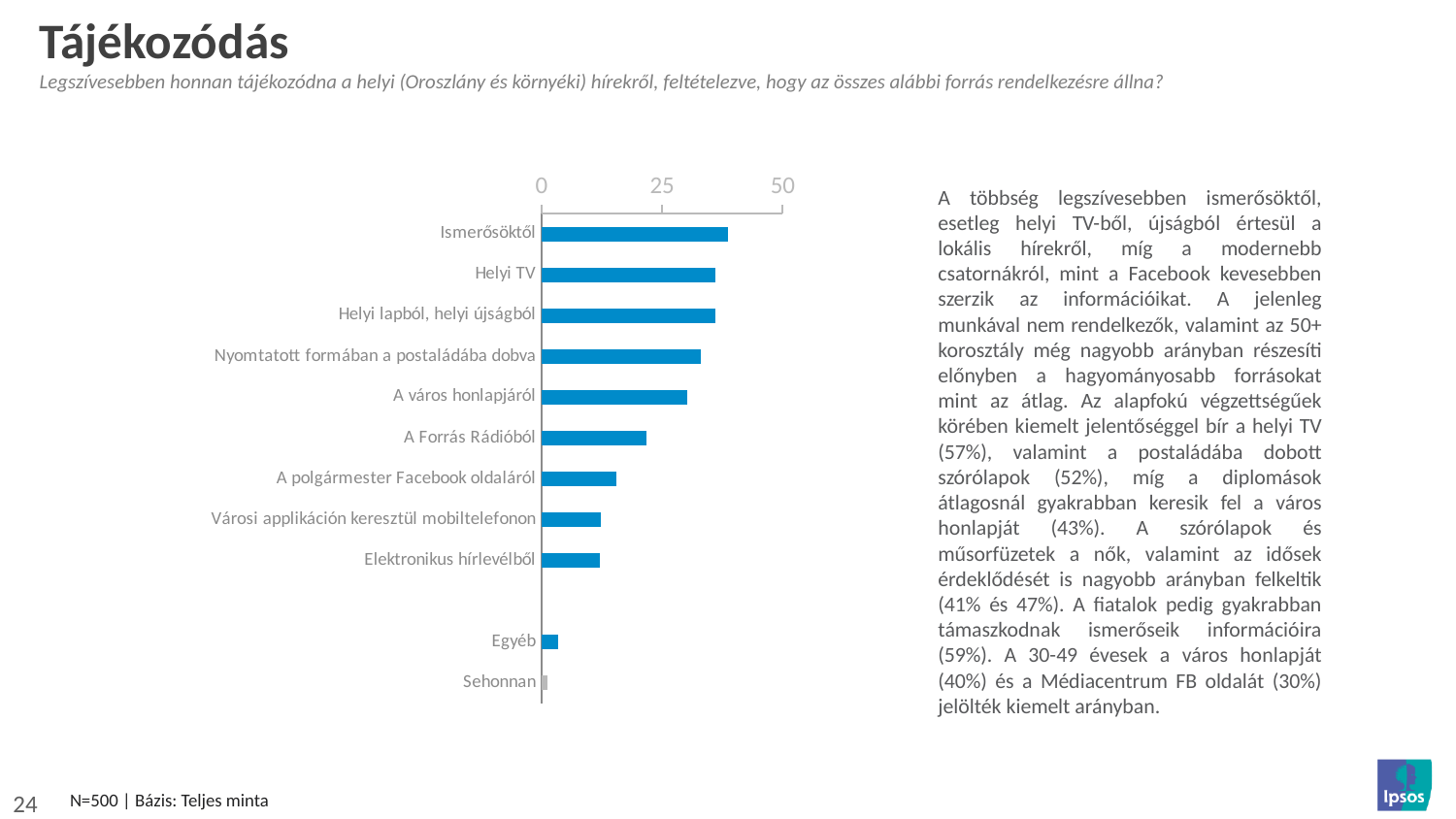
Which category has the highest value in the chart? Ismerősöktől Is the value for Nyomtatott formában a postaládába dobva greater or less than 25? greater Which is larger: the value for Elektronikus hírlevélből or the value for A város honlapjáról? A város honlapjáról What kind of chart is shown on the slide? bar chart What is the title of the slide containing the chart? Tájékozódás How many categories are plotted in the chart? 11 Which is larger: the value for Egyéb or the value for Sehonnan? Egyéb Which category has the lowest value in the chart? Sehonnan Is the value for A Forrás Rádióból greater or less than 25? less Is the value for Ismerősöktől greater or less than 25? greater Which is larger: the value for Ismerősöktől or the value for A Forrás Rádióból? Ismerősöktől